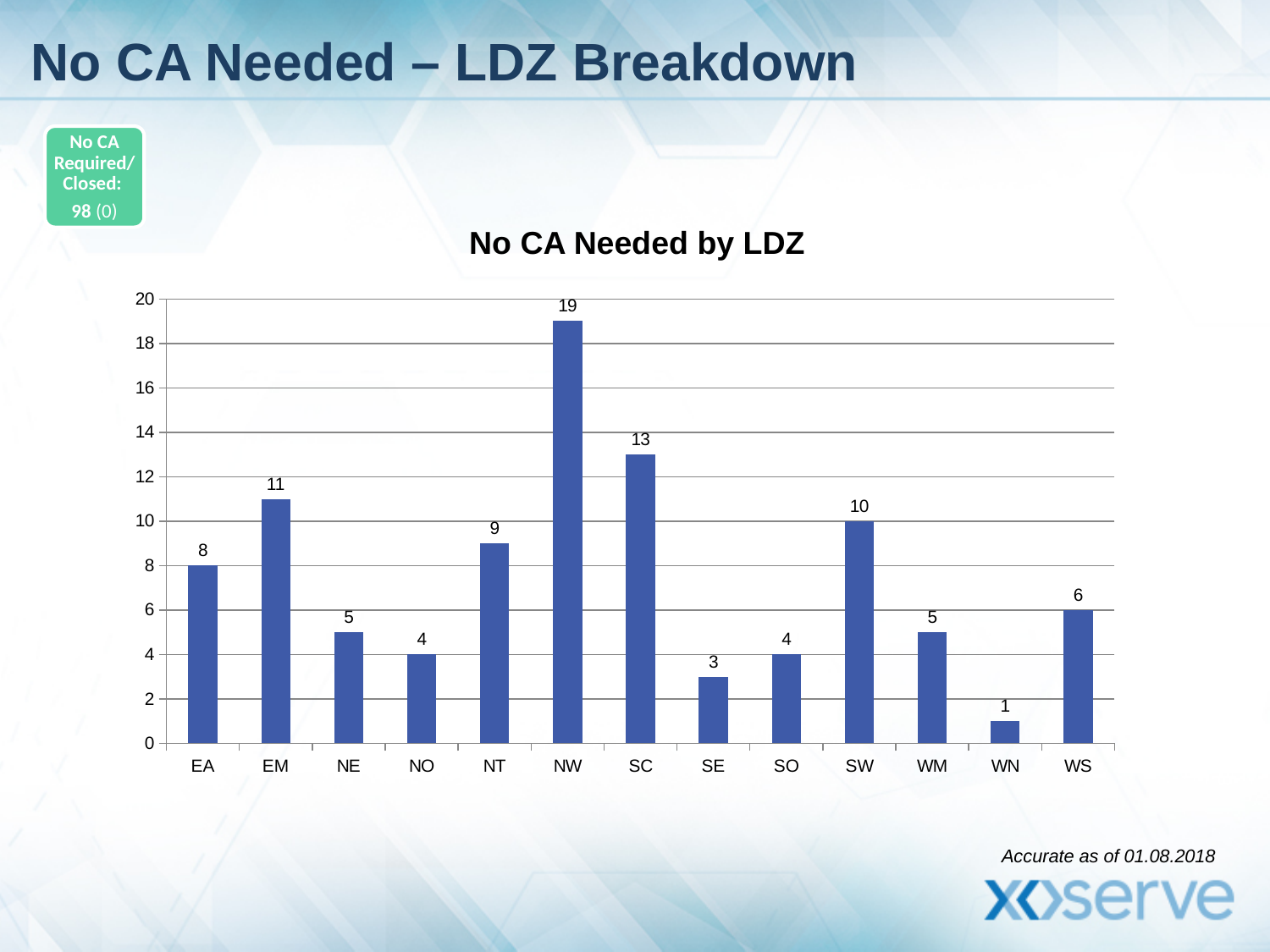
Which LDZ has the lowest value? WN Is the value for NT greater or less than 10? less What is the difference between the values for NW and SC? 6 What is the difference between the values for EA and WS? 2 What is the value for NW in the chart? 19 What is the title of the chart? No CA Needed by LDZ What kind of chart is shown on the slide? bar chart How many LDZ categories are shown on the x axis? 13 Which is larger, the value for EM or the value for SW? EM Which LDZ has the highest value? NW What is the value for SC in the chart? 13 What is the value for WN in the chart? 1